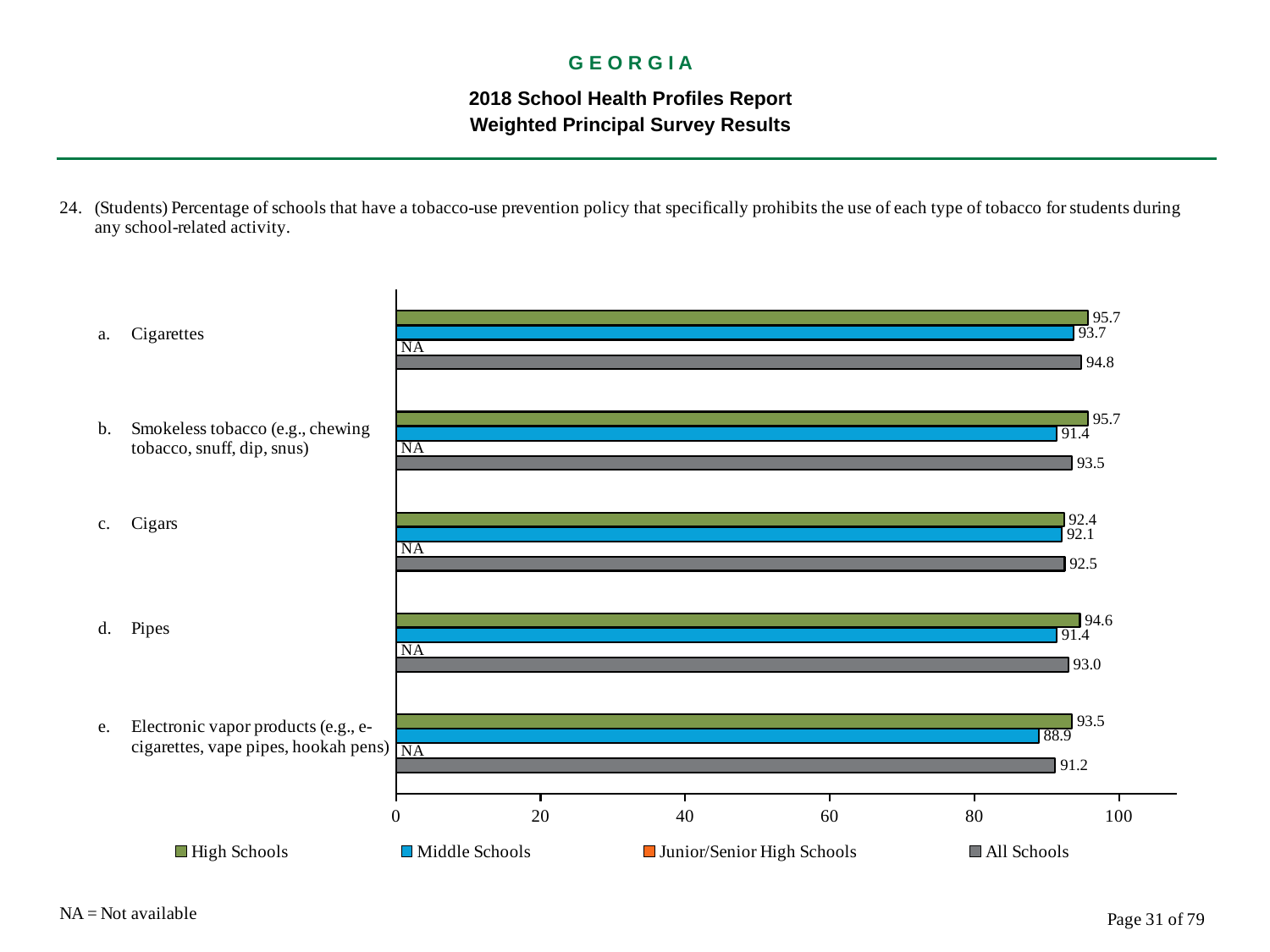
What is the value for Middle Schools for Smokeless tobacco? 91.4 How many series does the legend list? 4 Which is larger for Cigars: the High Schools value or the Middle Schools value? High Schools What is the difference between the High Schools and Middle Schools values for Electronic vapor products? 4.6 What kind of chart is shown? Bar chart How many categories are shown on the chart? 5 Which category has the highest All Schools value? Cigarettes Which category has the lowest Middle Schools value? Electronic vapor products What is the value for All Schools for Pipes? 93.0 What is the value for High Schools for Cigarettes? 95.7 What value is shown for Junior/Senior High Schools for Pipes? NA What is the value for Middle Schools for Electronic vapor products? 88.9